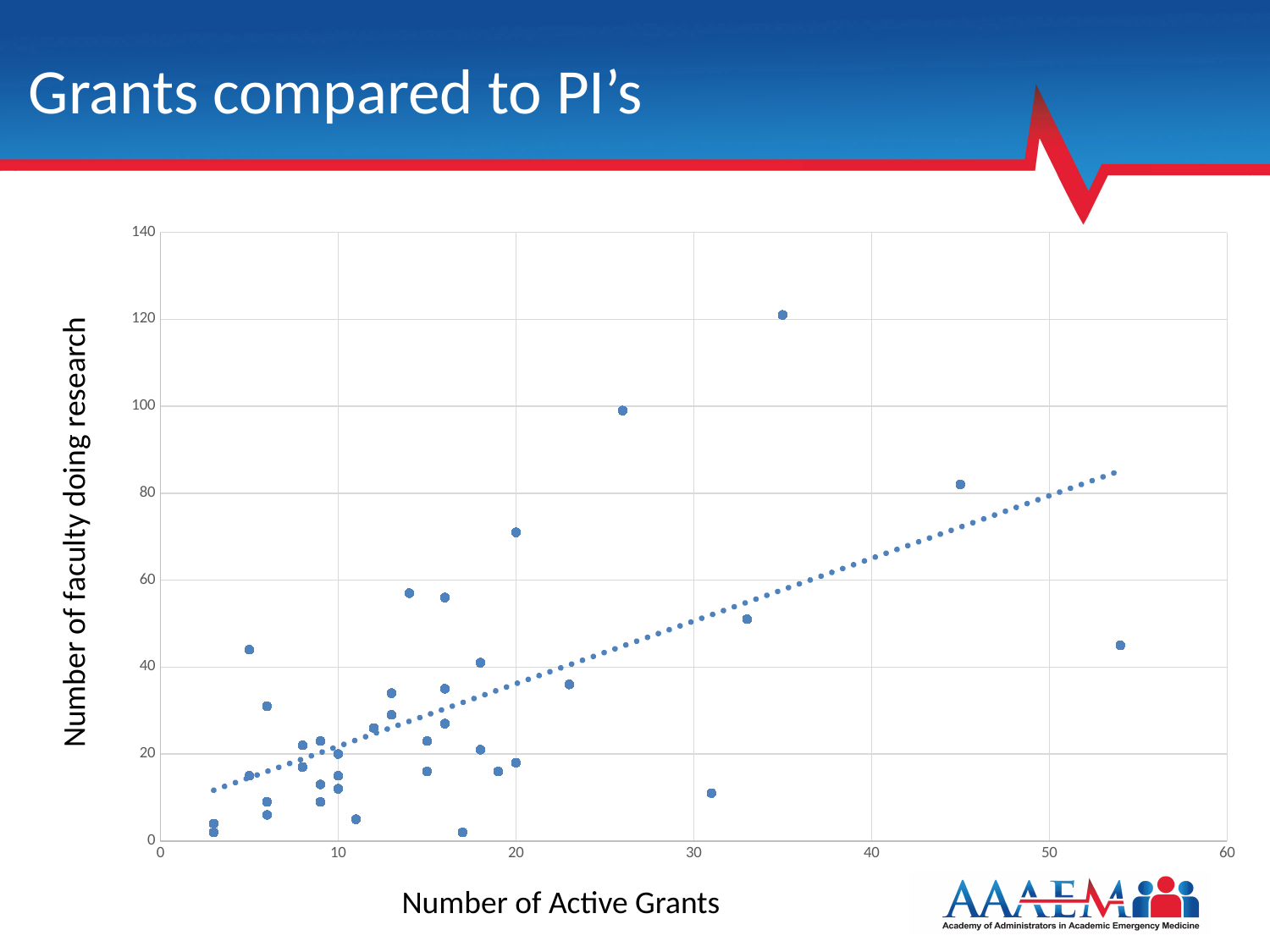
What kind of chart is shown on the slide? scatter chart What is the title of the chart on the slide? Grants compared to PI's What is the label of the vertical axis? Number of faculty doing research What is the highest value shown on the horizontal axis? 60 Is the value for the point with the most active grants (around 54 grants) greater or less than 40 faculty doing research? greater Is the highest point on the chart greater or less than 100 on the vertical axis? greater Which has more faculty doing research: the point at about 35 active grants or the point at about 45 active grants? the point at about 35 active grants Is the value for the point with the most active grants (around 54 grants) greater or less than 60 faculty doing research? less Does the dotted trend line rise or fall as the number of active grants increases? rises